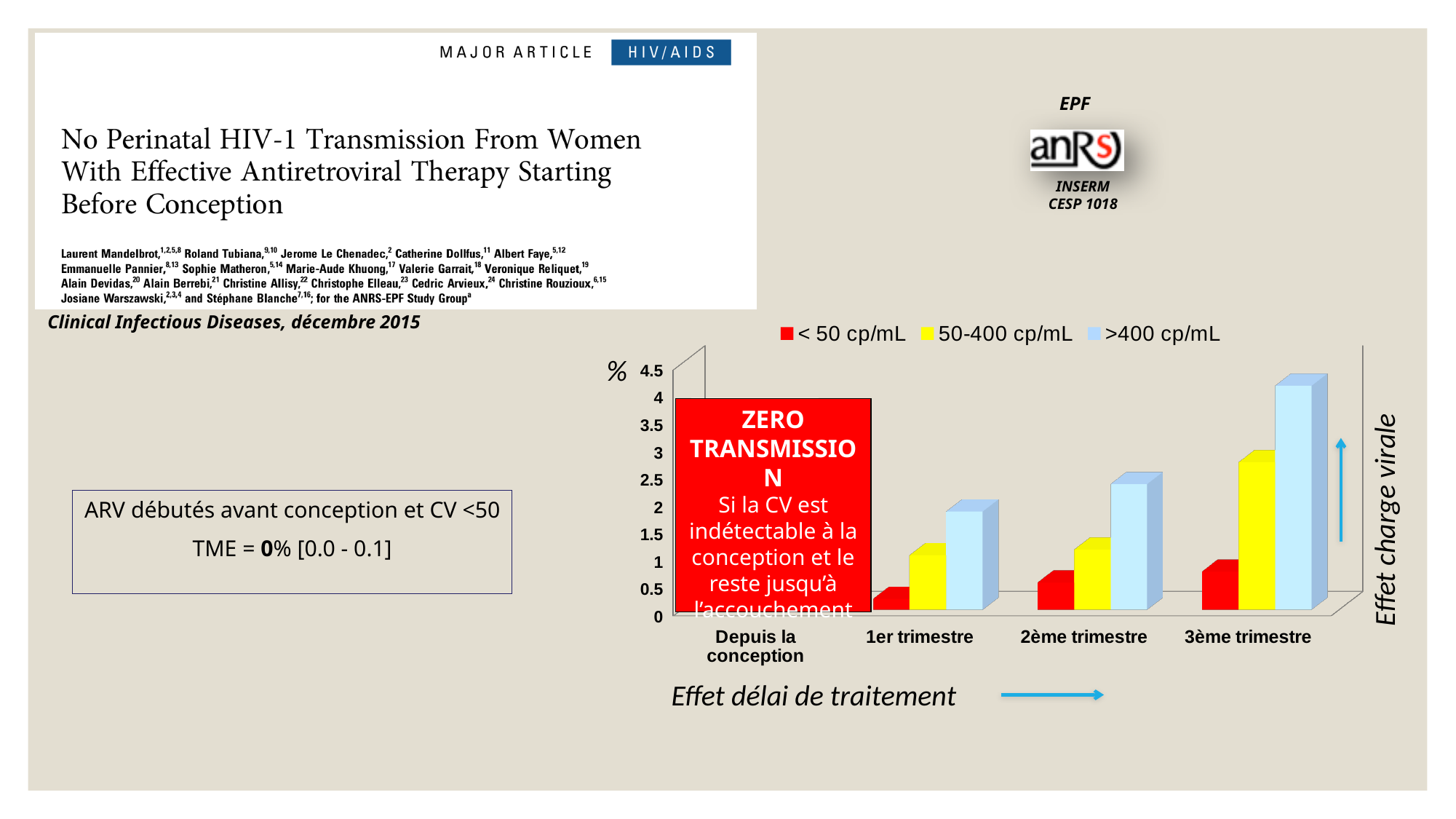
Which is larger: the 50-400 cp/mL value at 2ème trimestre or at 3ème trimestre? 3ème trimestre Which category has the highest value for the >400 cp/mL series? 3ème trimestre How many categories are shown along the x axis of the chart? 4 Is the value for 50-400 cp/mL at 3ème trimestre greater or less than 2? greater Is the value for >400 cp/mL at 3ème trimestre greater or less than 3? greater Which legend entry is shown in red? < 50 cp/mL Is the value for < 50 cp/mL at 1er trimestre greater or less than 1? less Do the values for the >400 cp/mL series rise or fall from 1er trimestre to 3ème trimestre? rise What label is written at the top of the vertical axis of the chart? % What kind of chart is shown on the slide? bar chart How many series does the chart legend list? 3